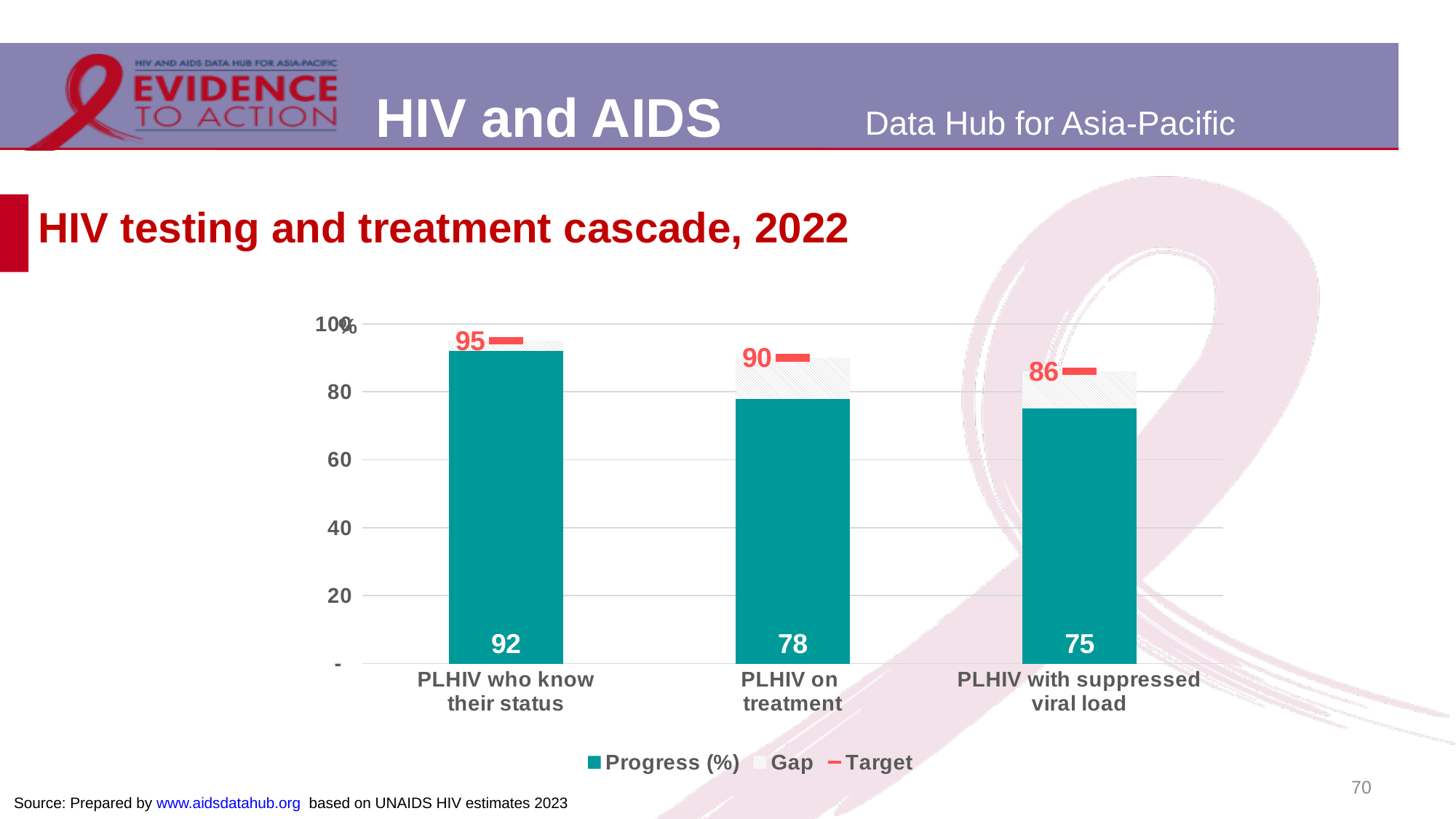
What is the Progress (%) value for PLHIV with suppressed viral load? 75 What is the Target value for PLHIV on treatment? 90 How many series does the legend list? 3 How many categories are shown on the x axis? 3 Which category has the lowest Progress (%) value? PLHIV with suppressed viral load What is the Progress (%) value for PLHIV who know their status? 92 What is the Progress (%) value for PLHIV on treatment? 78 What is the difference between the Progress (%) values for PLHIV on treatment and PLHIV with suppressed viral load? 3 What is the difference between the Target and the Progress (%) value for PLHIV who know their status? 3 Which category has the highest Progress (%) value? PLHIV who know their status Do the Progress (%) values rise or fall from left to right along the x axis? fall What is the Target value for PLHIV with suppressed viral load? 86